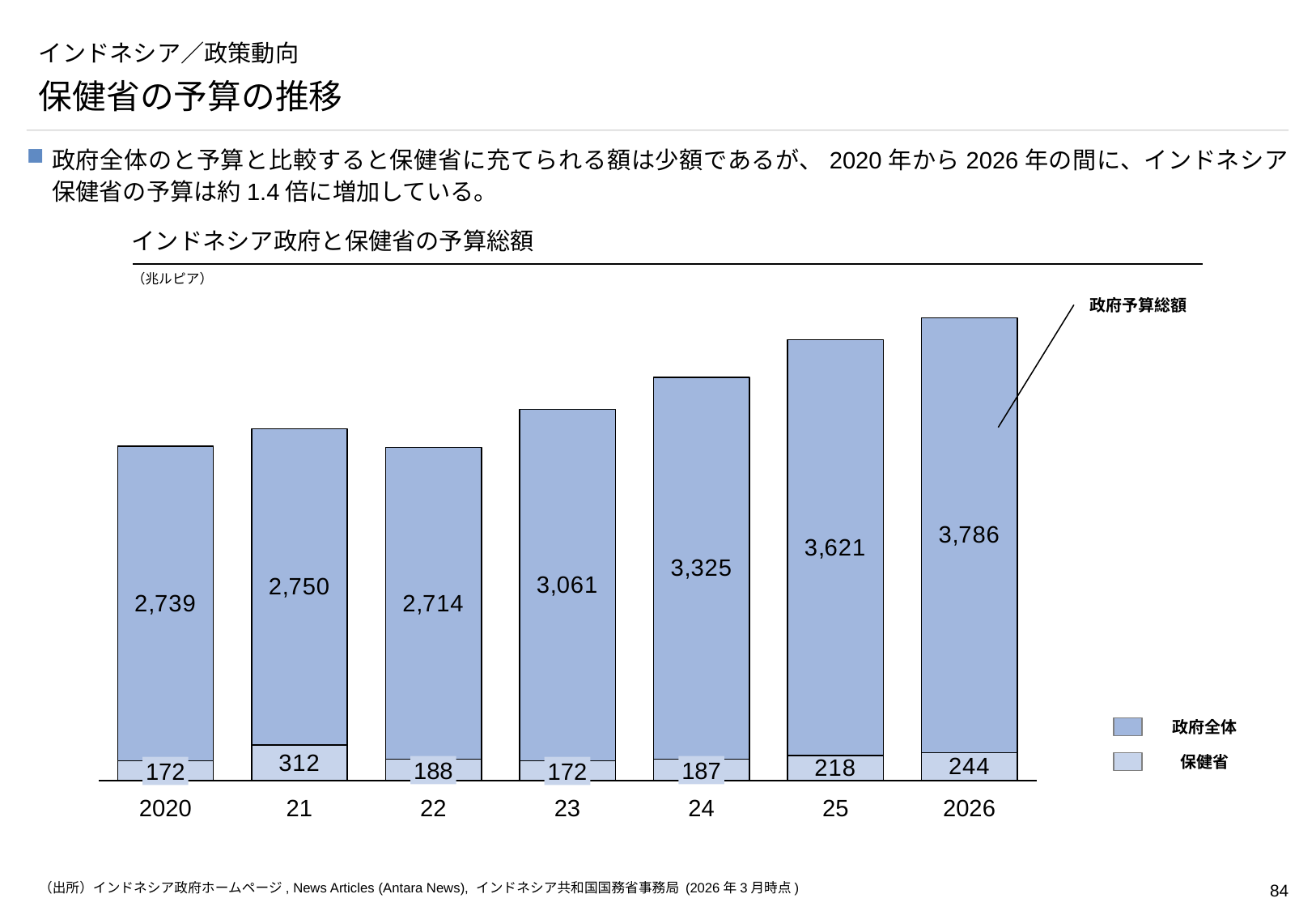
Which year has the highest 保健省 value? 21 What type of chart is shown on the slide? Stacked bar chart How many series does the legend list? 2 What is the 政府全体 value for 2020? 2,739 Which is larger, the 保健省 value for 25 or for 24? 25 How many years are shown on the x axis? 7 What is the difference between the 政府全体 values for 2026 and 2020? 1,047 Which year has the highest 政府全体 value? 2026 What is the 保健省 value for 21? 312 What is the total of the stacked bar for 2026? 4,030 What is the 保健省 value for 2026? 244 Which year has the lowest 政府全体 value? 22